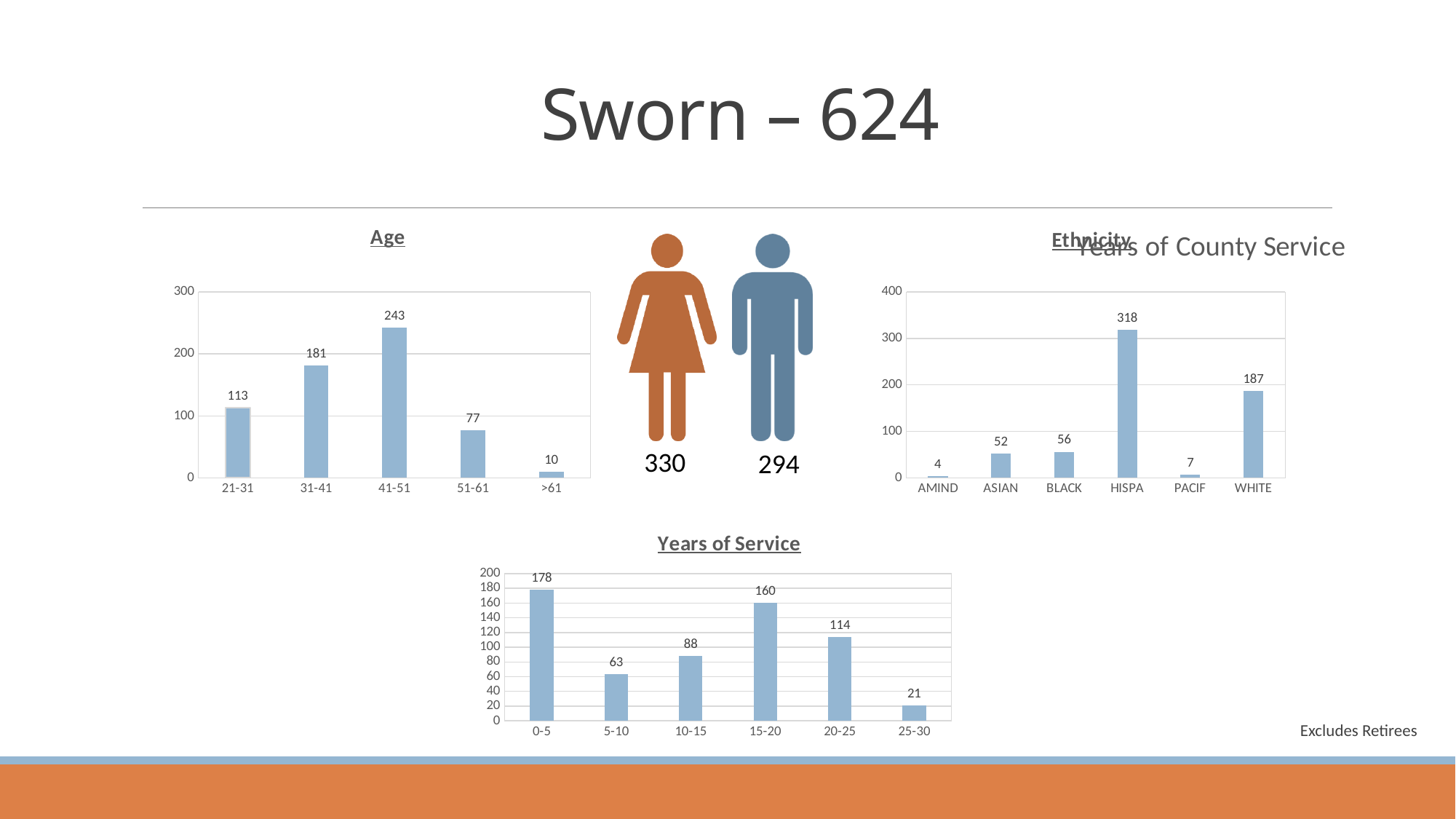
In the Age chart, what is the value for the 41-51 category? 243 In the Ethnicity chart, which category has the highest value? HISPA In the Ethnicity chart, which is larger, ASIAN or BLACK? BLACK In the Years of Service chart, what is the value for 10-15? 88 In the Age chart, what is the difference between the 31-41 and 51-61 values? 104 In the Years of Service chart, how many categories are shown? 6 In the Years of Service chart, which category has the highest value? 0-5 What type of chart is the Years of Service chart? Bar chart In the Age chart, how many age categories are shown? 5 In the Ethnicity chart, what is the difference between the WHITE and PACIF values? 180 In the Age chart, which age category has the lowest value? >61 In the Ethnicity chart, what is the value for HISPA? 318